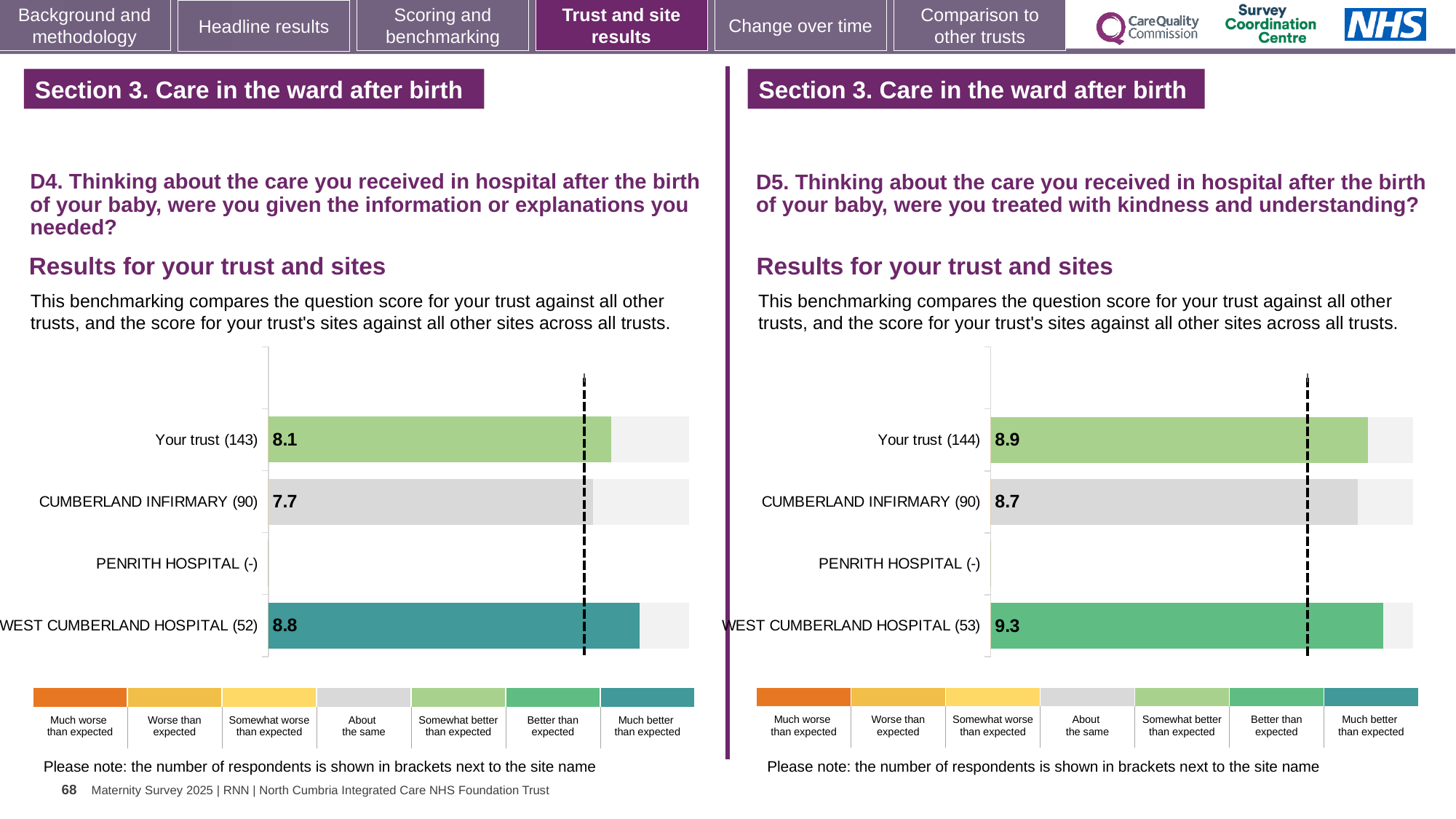
In the D4 chart on the left, which row with a plotted score has the lowest score? CUMBERLAND INFIRMARY What type of chart is used for the D5 results on the right? Bar chart In the D4 chart on the left, what is the score for CUMBERLAND INFIRMARY? 7.7 How many rows (trust and sites) are listed on the y axis of the D4 chart on the left? 4 In the D5 chart on the right, what is the difference between the scores for Your trust and CUMBERLAND INFIRMARY? 0.2 In the D5 chart on the right, what is the score for WEST CUMBERLAND HOSPITAL? 9.3 In the D5 chart on the right, which has the higher score, Your trust or CUMBERLAND INFIRMARY? Your trust In the D5 chart on the right, what is the score for Your trust? 8.9 In the D4 chart on the left, what is the score for Your trust? 8.1 In the D5 chart on the right, which site or trust row has the highest score? WEST CUMBERLAND HOSPITAL In the D4 chart on the left, what is the difference between the scores for WEST CUMBERLAND HOSPITAL and CUMBERLAND INFIRMARY? 1.1 In the D4 chart on the left, what is the score for WEST CUMBERLAND HOSPITAL? 8.8